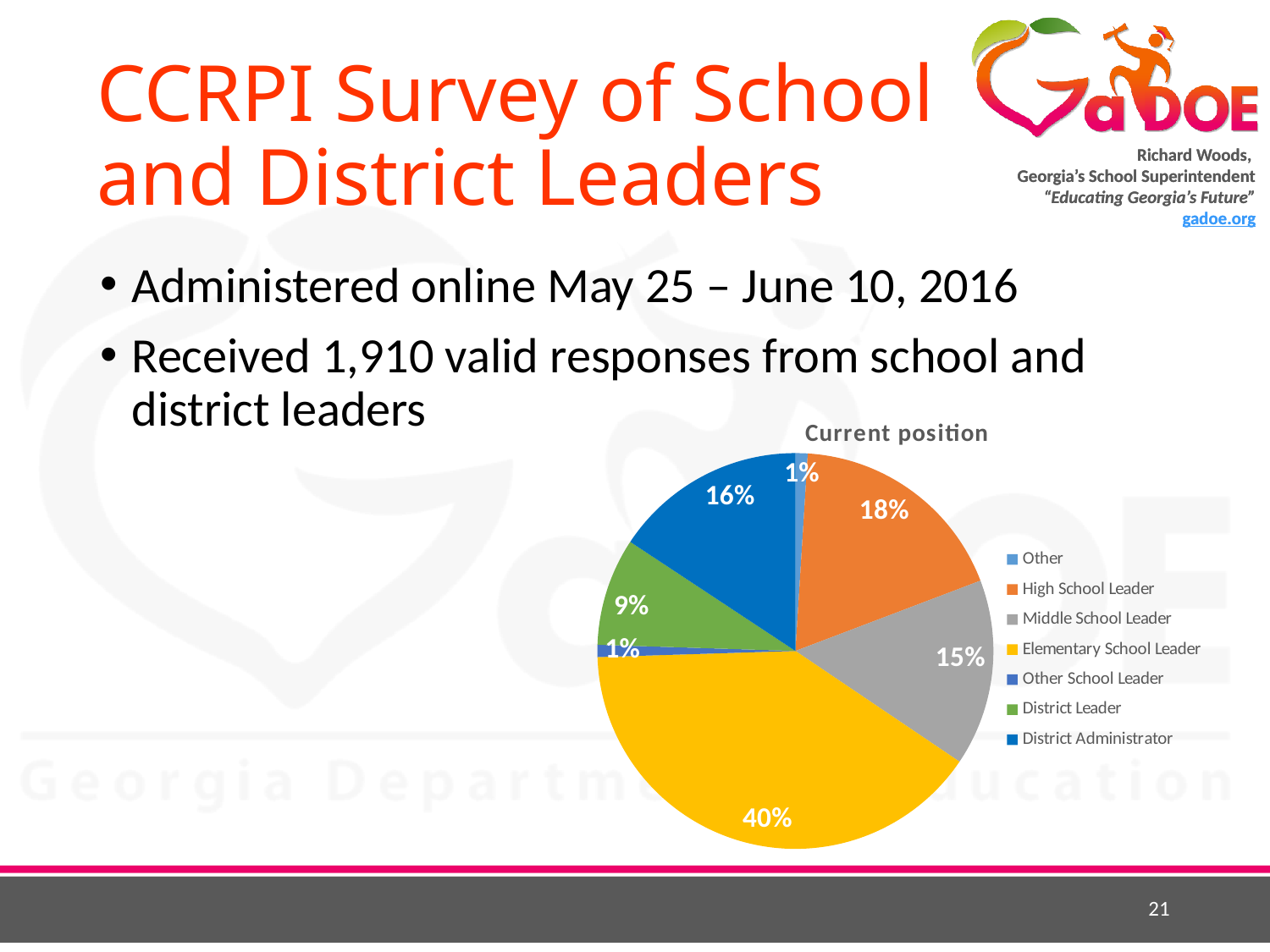
How many categories does the legend of the pie chart list? 7 What share of the pie chart is High School Leader? 18% What share of the pie chart is District Administrator? 16% What share of the pie chart is Middle School Leader? 15% What is the difference between the District Administrator share and the District Leader share? 7% Which is larger in the pie chart, High School Leader or Middle School Leader? High School Leader What is the difference between the Elementary School Leader share and the High School Leader share? 22% What kind of chart is shown on the slide? Pie chart What is the title of the pie chart? Current position Which category has the largest slice of the pie chart? Elementary School Leader